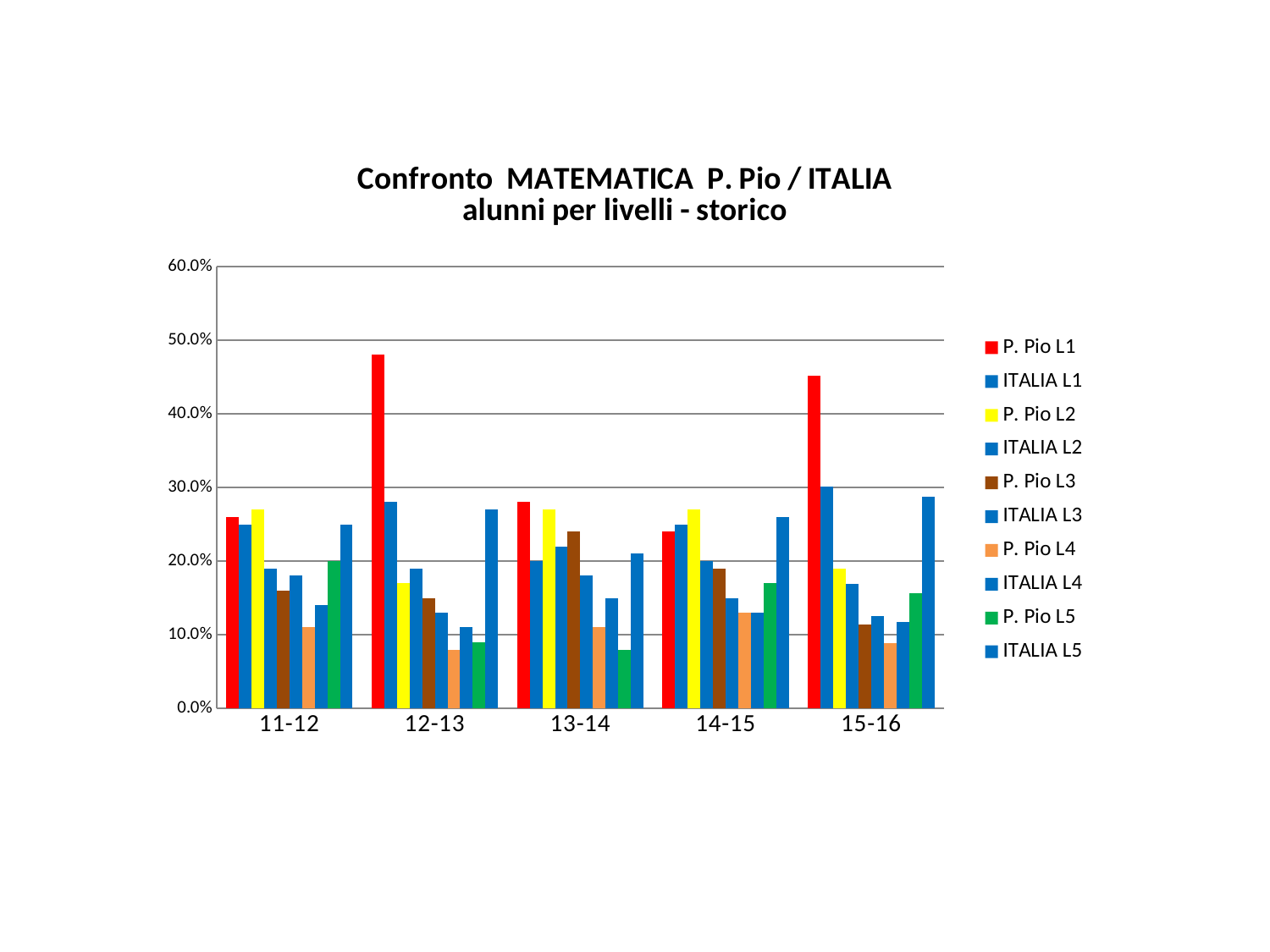
What colour represents the P. Pio L1 series in the legend? red Is the value for ITALIA L1 in 15-16 greater or less than 20.0%? greater In 15-16, which is larger: P. Pio L1 or ITALIA L1? P. Pio L1 Which series has the shortest bar in the 13-14 group? P. Pio L5 In 13-14, which is larger: P. Pio L3 or ITALIA L3? P. Pio L3 How many school-year categories are shown on the x axis? 5 Is the value for P. Pio L1 in 12-13 greater or less than 40.0%? greater Is the value for P. Pio L4 in 12-13 greater or less than 10.0%? less Which series has the tallest bar in the 12-13 group? P. Pio L1 How many series does the legend list? 10 What kind of chart is shown on the slide? bar chart What is the title of the chart? Confronto MATEMATICA P. Pio / ITALIA alunni per livelli - storico